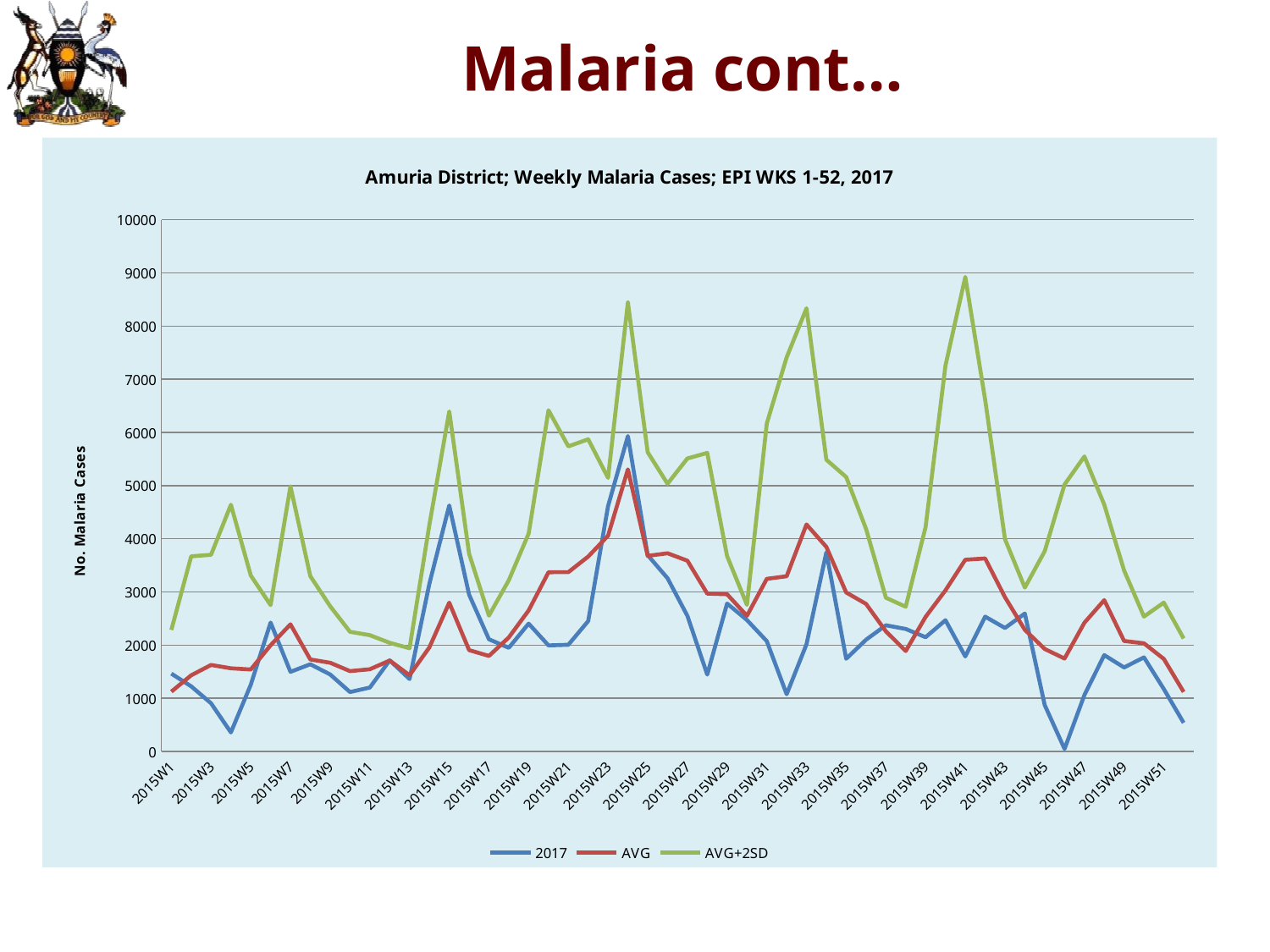
Is the value of the AVG+2SD series at 2015W1 greater or less than 2000? greater Is the highest value of the AVG+2SD series greater or less than 8000? greater At 2015W41, which series has the higher value, 2017 or AVG+2SD? AVG+2SD Is the value of the 2017 series at 2015W1 greater or less than 2000? less What kind of chart is shown on the slide? line chart What is the title of the chart? Amuria District; Weekly Malaria Cases; EPI WKS 1-52, 2017 Which series reaches the highest value on the chart? AVG+2SD Does the AVG+2SD series rise or fall from 2015W47 to 2015W51? fall How many week labels are shown on the x axis? 26 How many series does the legend list? 3 What are the three series named in the legend? 2017, AVG, AVG+2SD